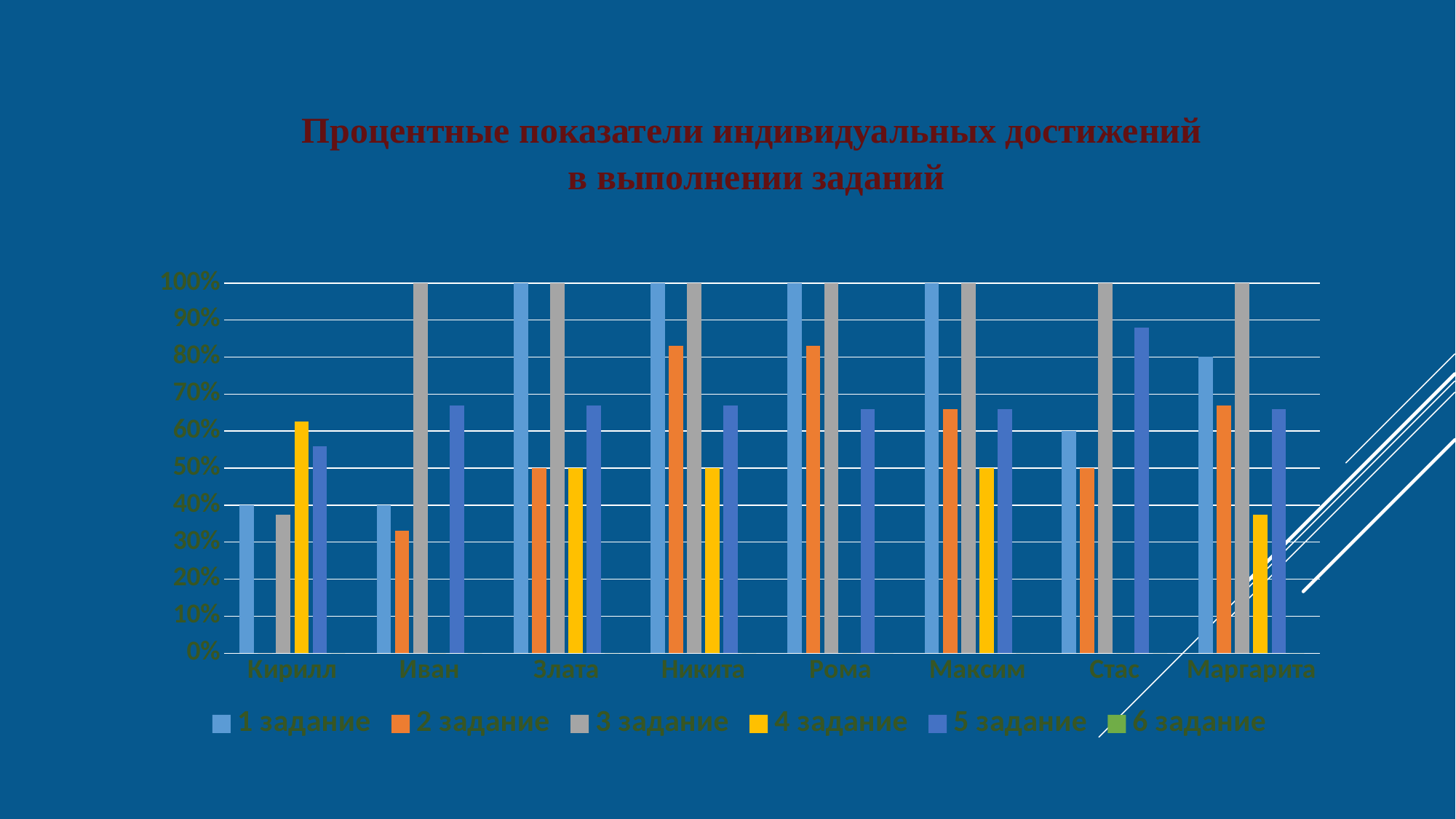
Which is larger: 1 задание for Маргарита or 1 задание for Стас? Маргарита Is the value of 5 задание for Стас greater or less than 80%? greater What is the difference between 1 задание for Маргарита and 1 задание for Кирилл? 40% Is the value of 2 задание for Иван greater or less than 40%? less What is the value of 3 задание for Иван? 100% What kind of chart is shown on the slide? bar chart What is the value of 1 задание for Маргарита? 80% What is the value of 1 задание for Кирилл? 40% How many series does the legend list? 6 How many people (categories) are shown on the x axis? 8 What is the value of 1 задание for Стас? 60% Which series has the highest value for Стас? 3 задание